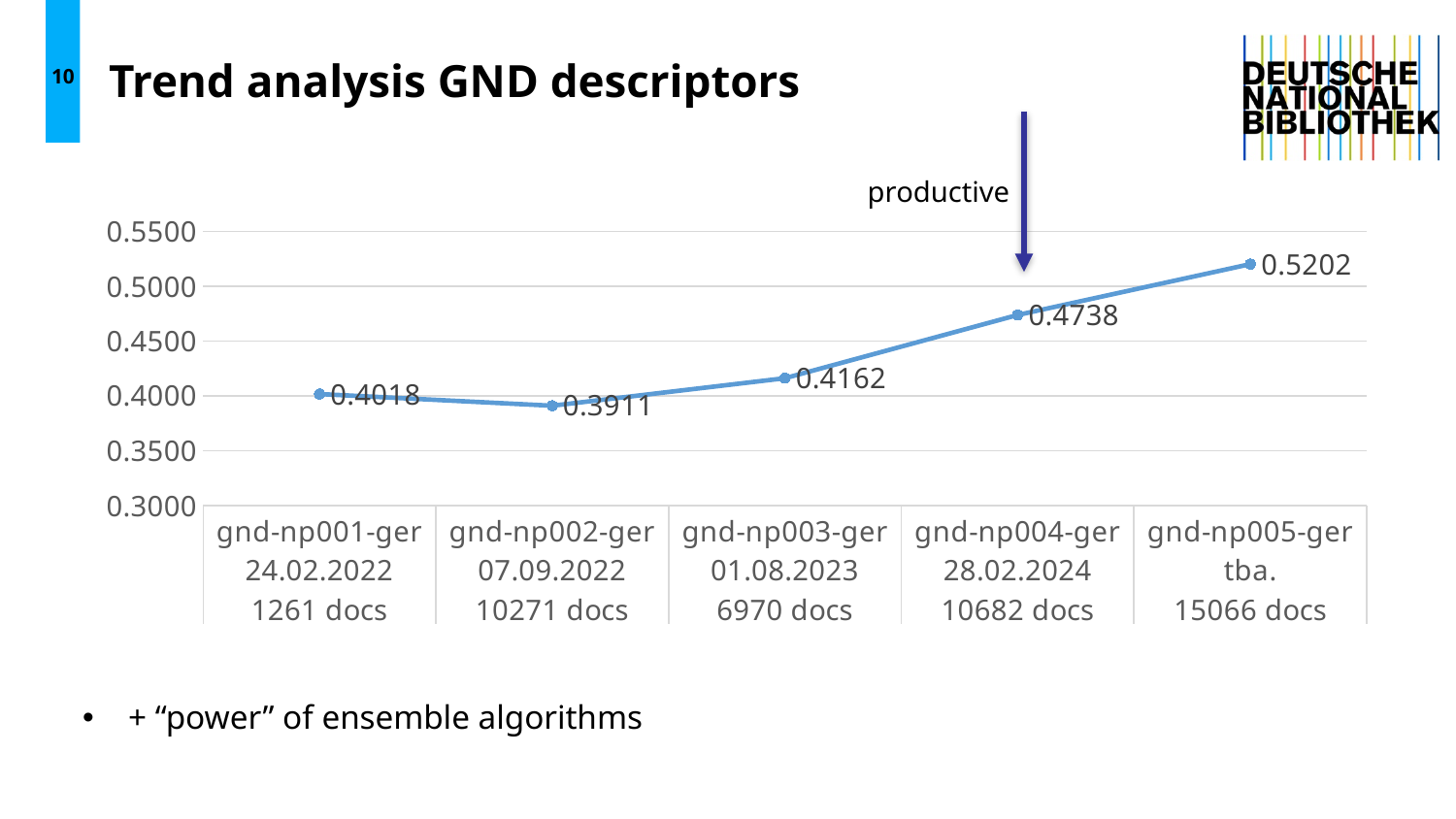
Do the values rise or fall from gnd-np002-ger to gnd-np005-ger? rise Which category has the lowest value? gnd-np002-ger What is the value for gnd-np003-ger? 0.4162 What is the value for gnd-np004-ger? 0.4738 What is the value for gnd-np002-ger? 0.3911 What is the value for gnd-np005-ger? 0.5202 Which is larger, the value for gnd-np003-ger or gnd-np001-ger? gnd-np003-ger How many data points are plotted on the chart? 5 Which category has the highest value? gnd-np005-ger What is the difference between the values for gnd-np005-ger and gnd-np004-ger? 0.0464 What is the value for gnd-np001-ger? 0.4018 What kind of chart is shown on the slide? line chart